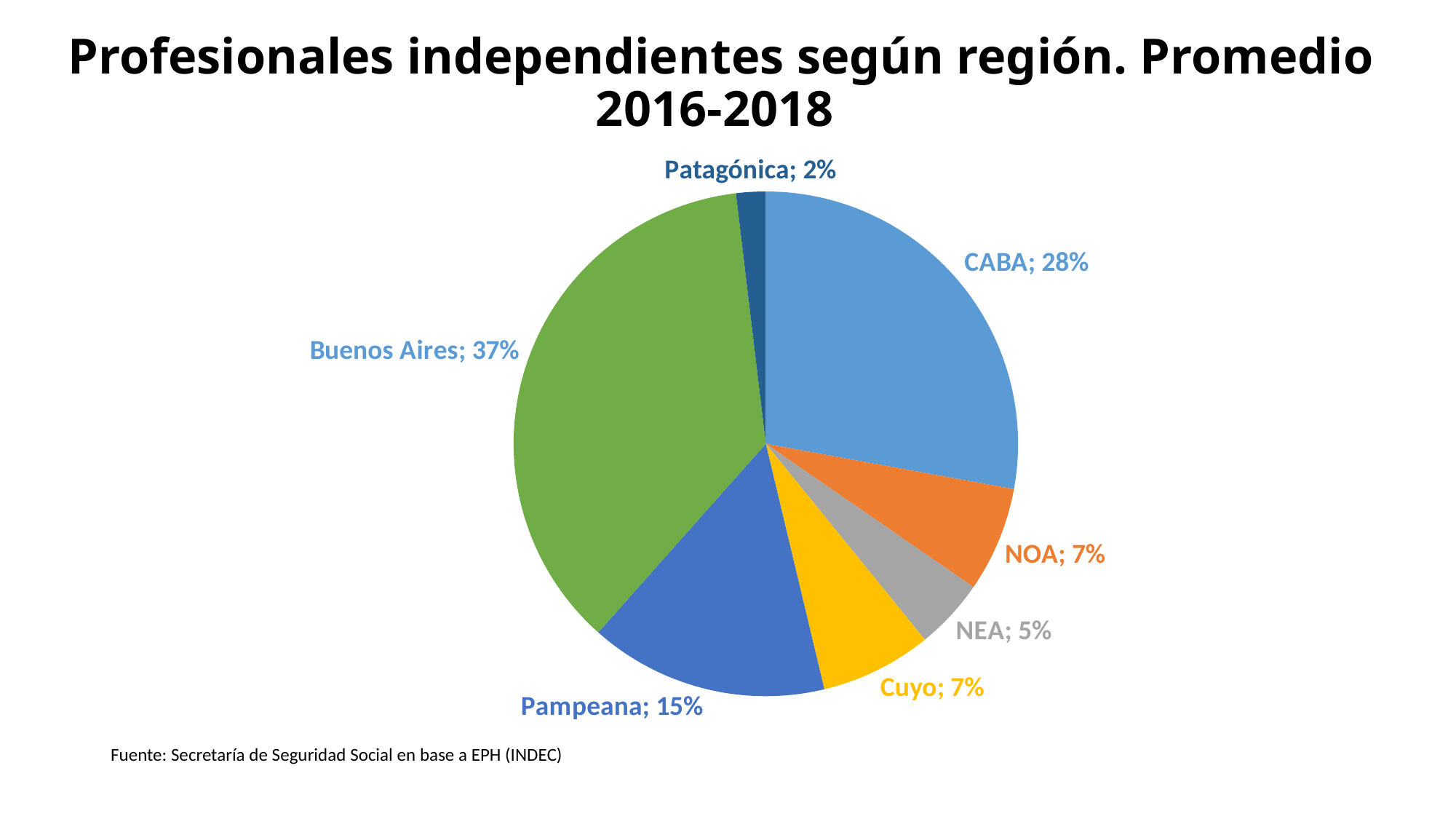
What kind of chart is shown on the slide? pie chart What share of independent professionals is in the Pampeana region? 15% What is the source cited below the chart? Secretaría de Seguridad Social en base a EPH (INDEC) Which region has the smallest share of independent professionals? Patagónica What share of independent professionals is in CABA? 28% Which region has the largest share of independent professionals? Buenos Aires What share of independent professionals is in the NEA region? 5% Which has a larger share, Pampeana or NOA? Pampeana What share of independent professionals is in the Patagónica region? 2% How many regions are shown in the pie chart? 7 What is the difference in percentage points between Buenos Aires and CABA? 9 What is the combined share of Buenos Aires and CABA? 65%